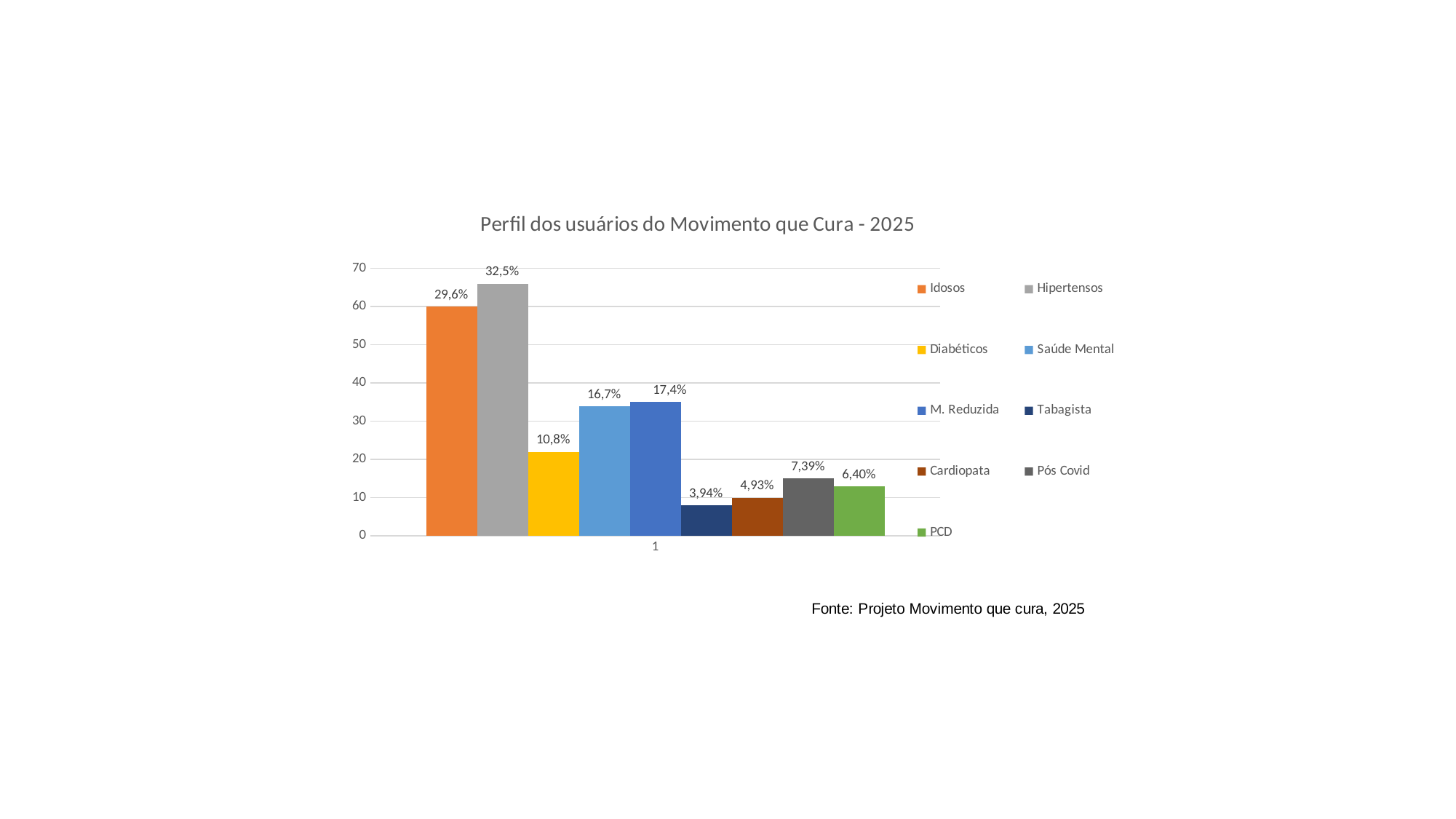
What is the data label shown for Pós Covid? 7,39% What is the difference between the data labels for Hipertensos and Idosos? 2,9% What is the data label shown for Hipertensos? 32,5% What is the data label shown for Idosos? 29,6% What is the data label shown for Tabagista? 3,94% What kind of chart is shown on the slide? Bar chart How many series does the legend list? 9 Which series has the highest value? Hipertensos What is the title of the chart? Perfil dos usuários do Movimento que Cura - 2025 Is the bar for Idosos greater or less than 50 on the vertical axis? greater Which series has the lowest value? Tabagista Which is larger, the value for Diabéticos or the value for Saúde Mental? Saúde Mental